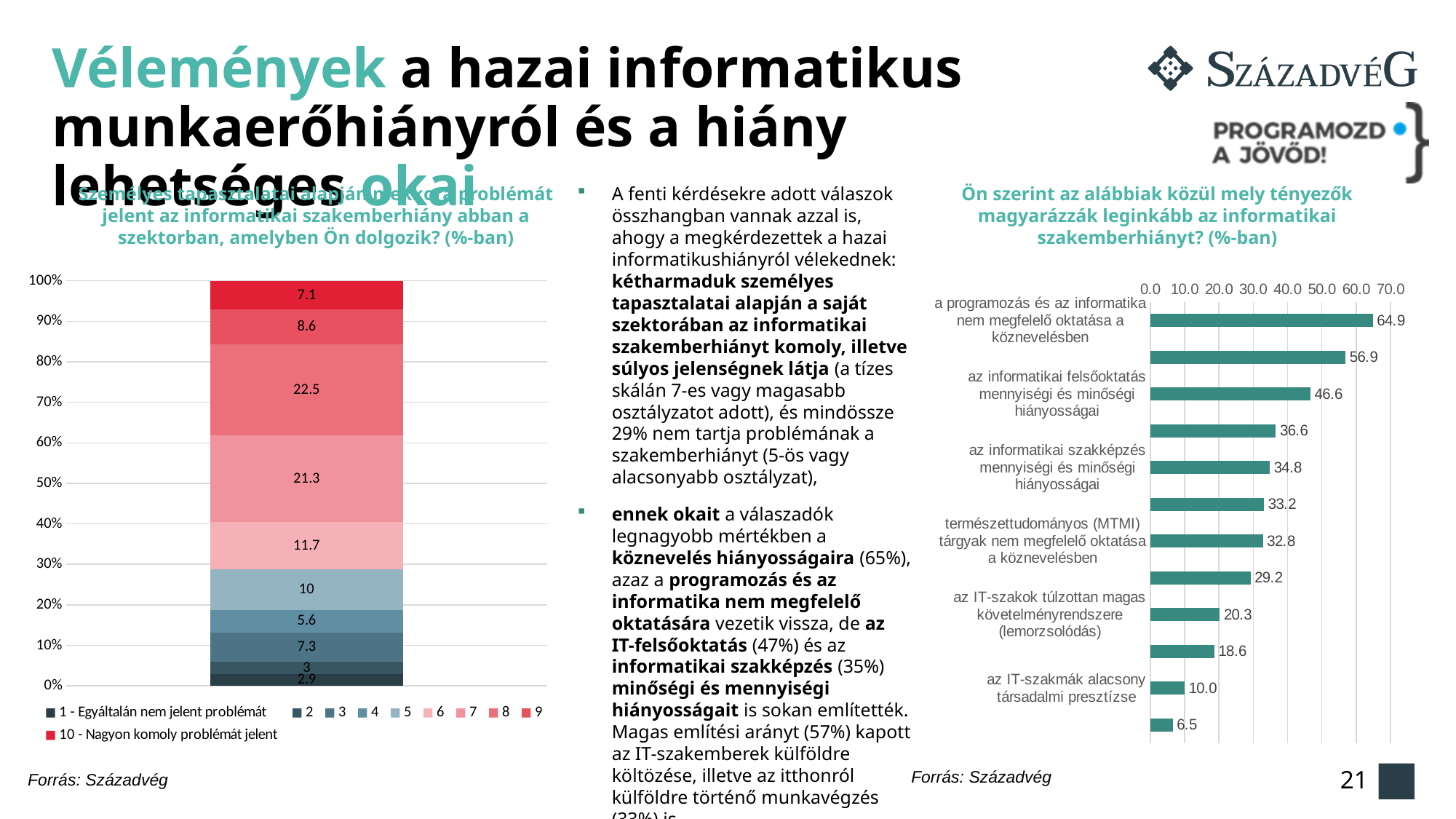
How many series does the legend of the left chart list? 10 In the right chart, what is the value for 'az informatikai felsőoktatás mennyiségi és minőségi hiányosságai'? 46.6 In the right chart, how many bars are plotted? 12 What type of chart is the right chart? bar chart In the right chart, which factor has the highest value? a programozás és az informatika nem megfelelő oktatása a köznevelésben In the left stacked bar chart, what is the value for the segment '1 - Egyáltalán nem jelent problémát'? 2.9 In the right chart, what is the difference between the value for 'a programozás és az informatika nem megfelelő oktatása a köznevelésben' and the value for 'az informatikai felsőoktatás mennyiségi és minőségi hiányosságai'? 18.3 In the left stacked bar chart, which is larger: the value for segment 7 or the value for segment 6? 7 In the right chart, what is the smallest value shown? 6.5 In the left stacked bar chart, what is the value for the segment '10 - Nagyon komoly problémát jelent'? 7.1 In the right chart (Ön szerint az alábbiak közül mely tényezők magyarázzák leginkább az informatikai szakemberhiányt?), what is the value for 'a programozás és az informatika nem megfelelő oktatása a köznevelésben'? 64.9 In the right chart, what is the value for 'az IT-szakmák alacsony társadalmi presztízse'? 10.0